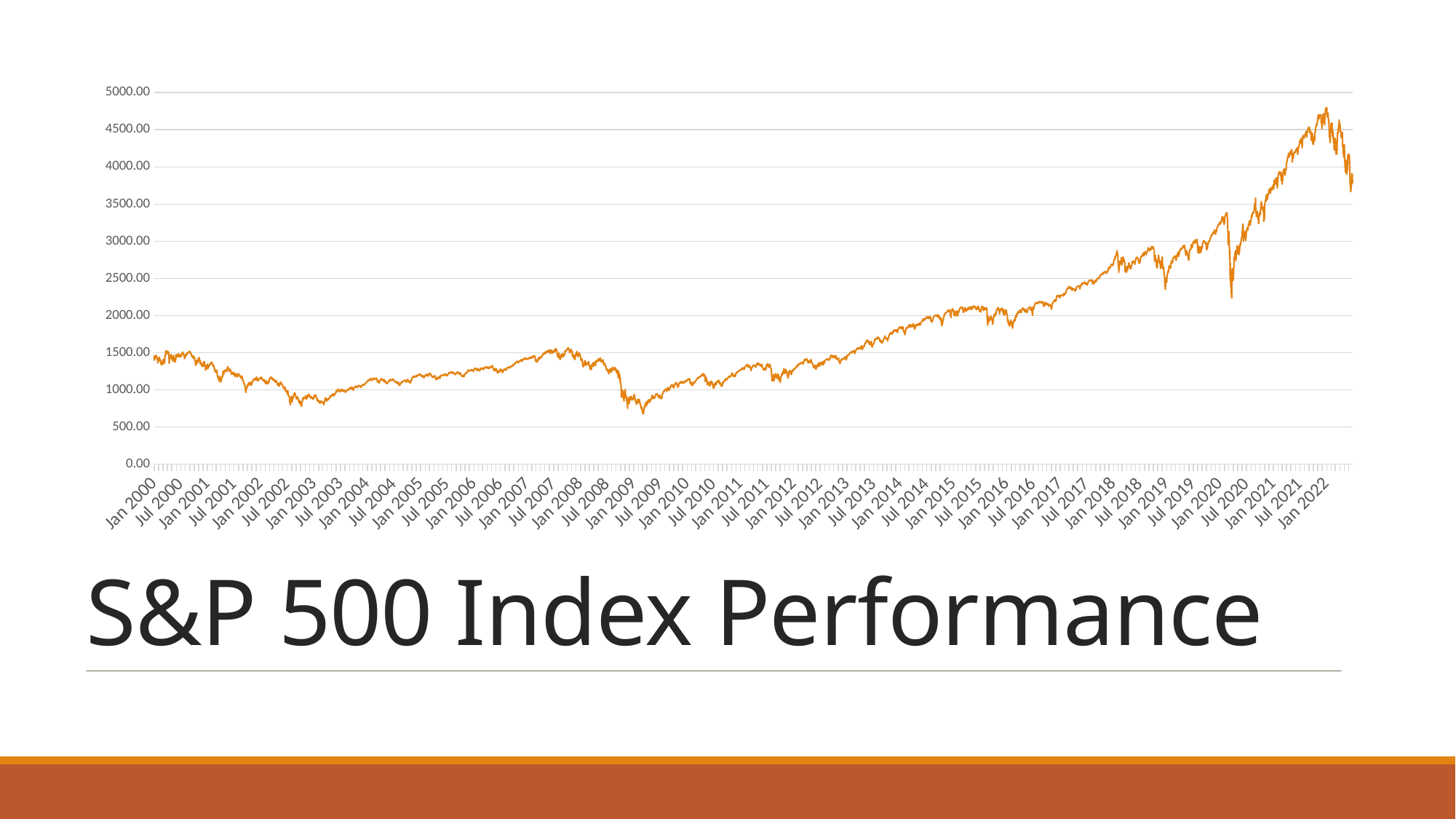
What is the title of the slide containing the chart? S&P 500 Index Performance Which is larger, the value at Jan 2000 or the value at Jan 2021? Jan 2021 Is the value at Jan 2022 greater or less than 4500? greater Is the value at Jan 2005 greater or less than 1500? less What colour is the line plotted on the chart? orange Does the line rise or fall between Jan 2009 and Jan 2020? rise Is the value at Jan 2009 greater or less than 1000? less What kind of chart is shown on the slide? line chart Does the line rise or fall between Jan 2000 and Jan 2003? fall Overall, does the line rise or fall from Jan 2000 to the end of the chart? rise